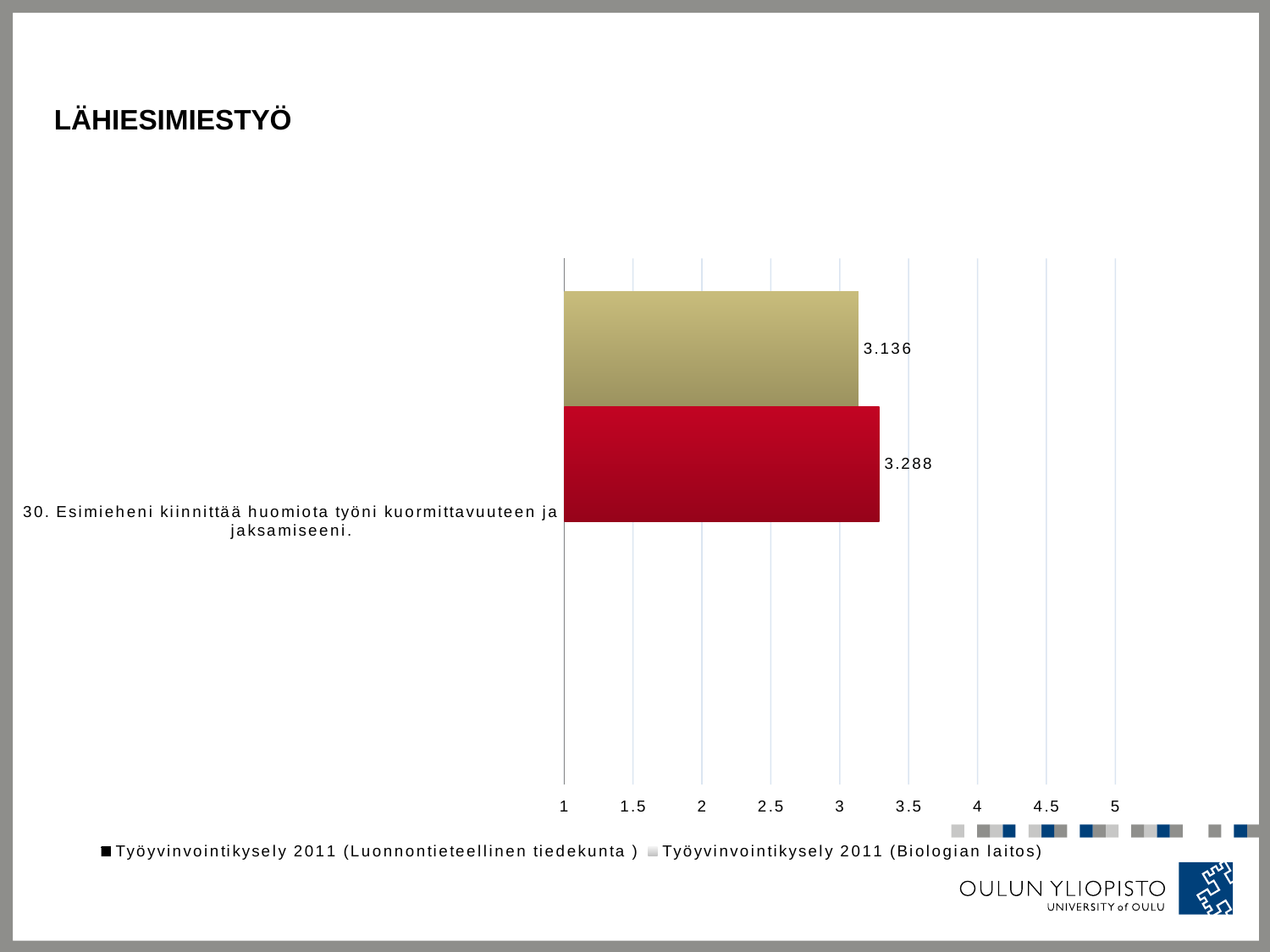
What is the value for Työyvinvointikysely 2011 (Biologian laitos) for item 30? 3.136 What kind of chart is shown on the slide? bar chart What is the difference between the Luonnontieteellinen tiedekunta value and the Biologian laitos value? 0.152 Is the value for Biologian laitos greater or less than 3.5? less What is the title of the slide? LÄHIESIMIESTYÖ What is the highest value shown on the x axis? 5 How many categories are plotted on the chart? 1 Which series has the higher value for item 30, Luonnontieteellinen tiedekunta or Biologian laitos? Luonnontieteellinen tiedekunta Is the value for Luonnontieteellinen tiedekunta greater or less than 3? greater What is the value for Työyvinvointikysely 2011 (Luonnontieteellinen tiedekunta) for item 30? 3.288 How many series does the legend list? 2